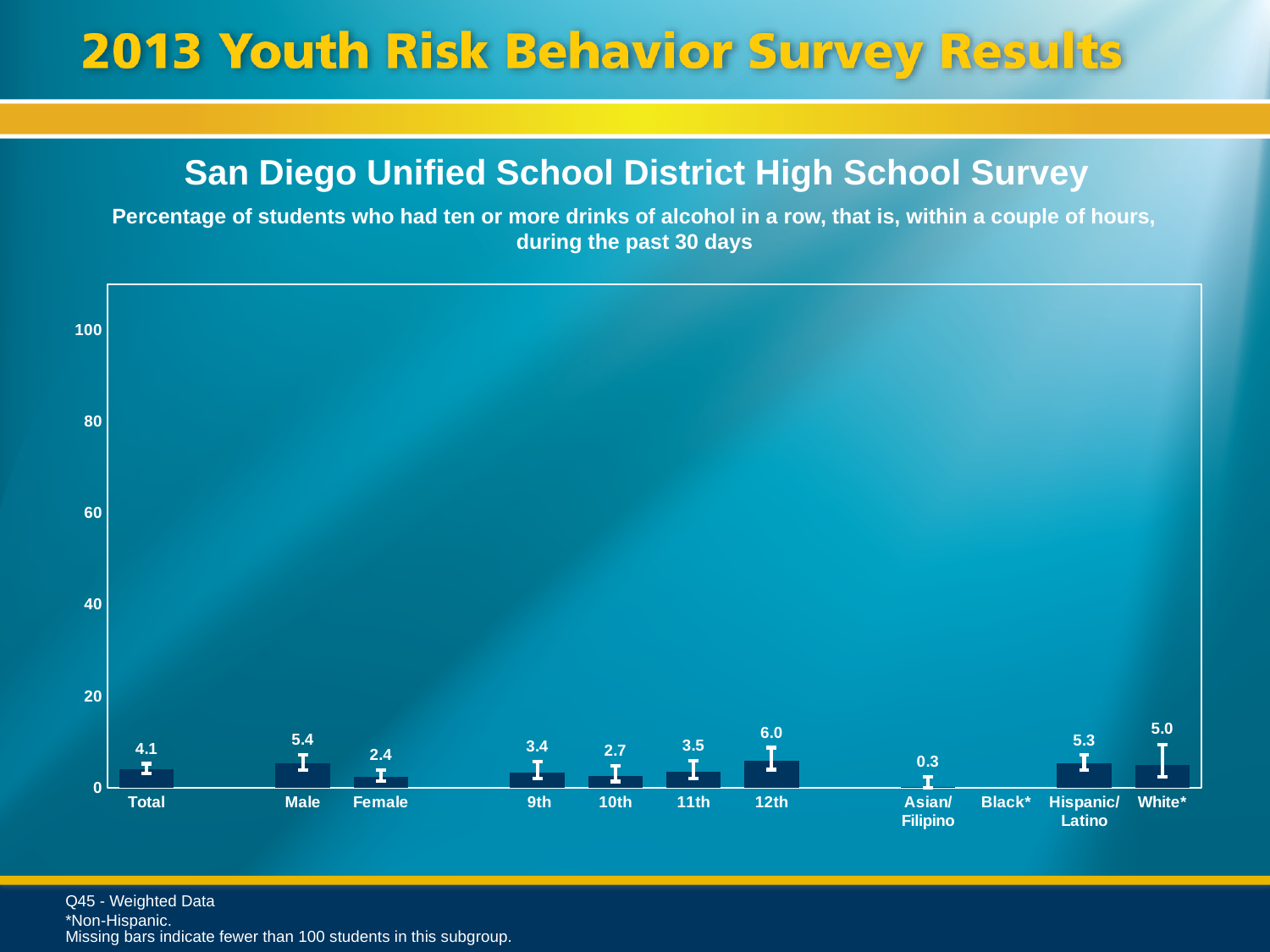
What is the value for Male? 5.4 What is the value for Hispanic/Latino? 5.3 Which category has no bar plotted? Black* What kind of chart is shown on the slide? bar chart Which category has the highest value? 12th Which is larger, the value for 9th or the value for 10th? 9th What is the difference between the values for Male and Female? 3.0 What is the value for Asian/Filipino? 0.3 What is the highest value shown on the y axis? 100 What is the value for Total? 4.1 Is the value for 12th greater or less than 20? less Which category with a plotted bar has the lowest value? Asian/Filipino